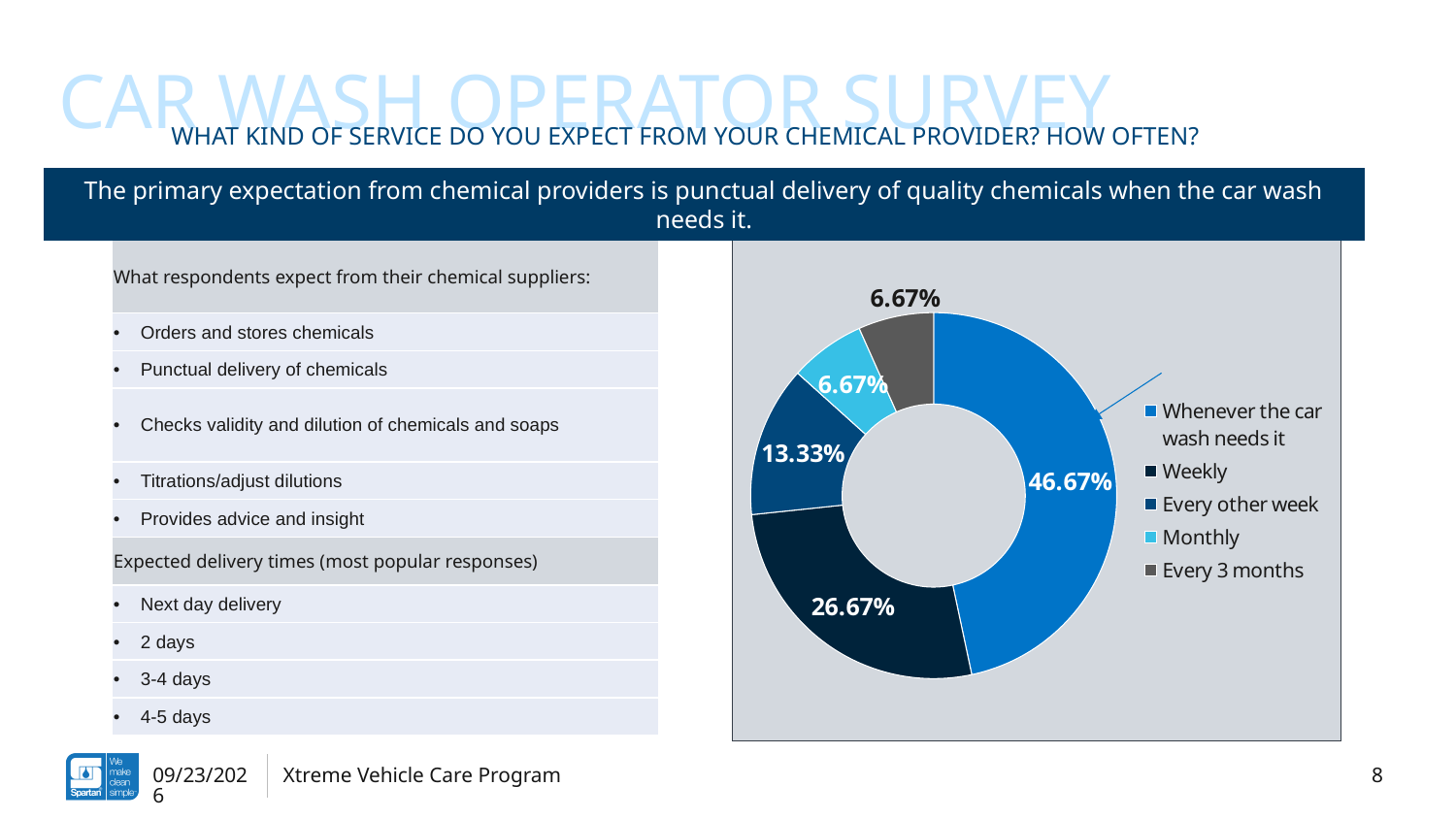
What percentage of respondents expect service every other week? 13.33% Which two service frequencies share the smallest percentage of respondents? Monthly and Every 3 months What colour is the slice for 'Every 3 months'? Gray What kind of chart is shown on the slide? Doughnut (pie) chart What is the difference in percentage points between 'Whenever the car wash needs it' and 'Weekly'? 20 percentage points Which has a larger share of respondents: Weekly or Every other week? Weekly What percentage of respondents expect service whenever the car wash needs it? 46.67% What percentage of respondents expect service every 3 months? 6.67% What percentage of respondents expect weekly service? 26.67% What percentage of respondents expect monthly service? 6.67% How many service frequency categories are shown in the chart? 5 Which service frequency has the largest share of respondents? Whenever the car wash needs it